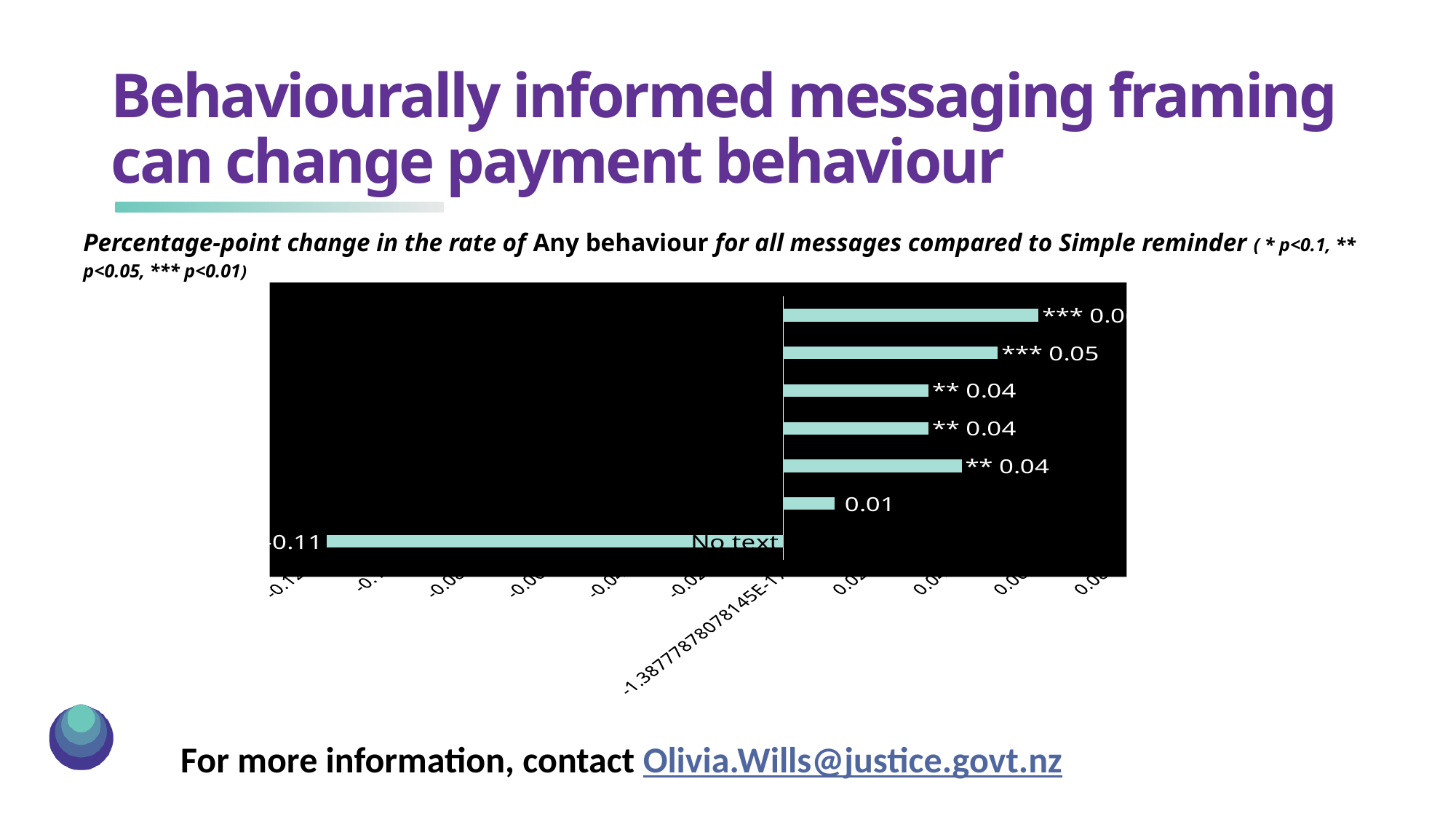
Which category has the lowest value in the chart? No text What is the value shown for the 'No text' bar? -0.11 How many bars are marked with three asterisks (***)? 2 How many bars in the chart have a negative value? 1 What is the data label on the second bar from the top? *** 0.05 Is the value for 'No text' greater or less than -0.1? less How many bars in the chart have a positive value? 6 What is the background colour of the chart's plot area? black What is the data label on the bar directly above the 'No text' bar? 0.01 What kind of chart is shown on the slide? bar chart